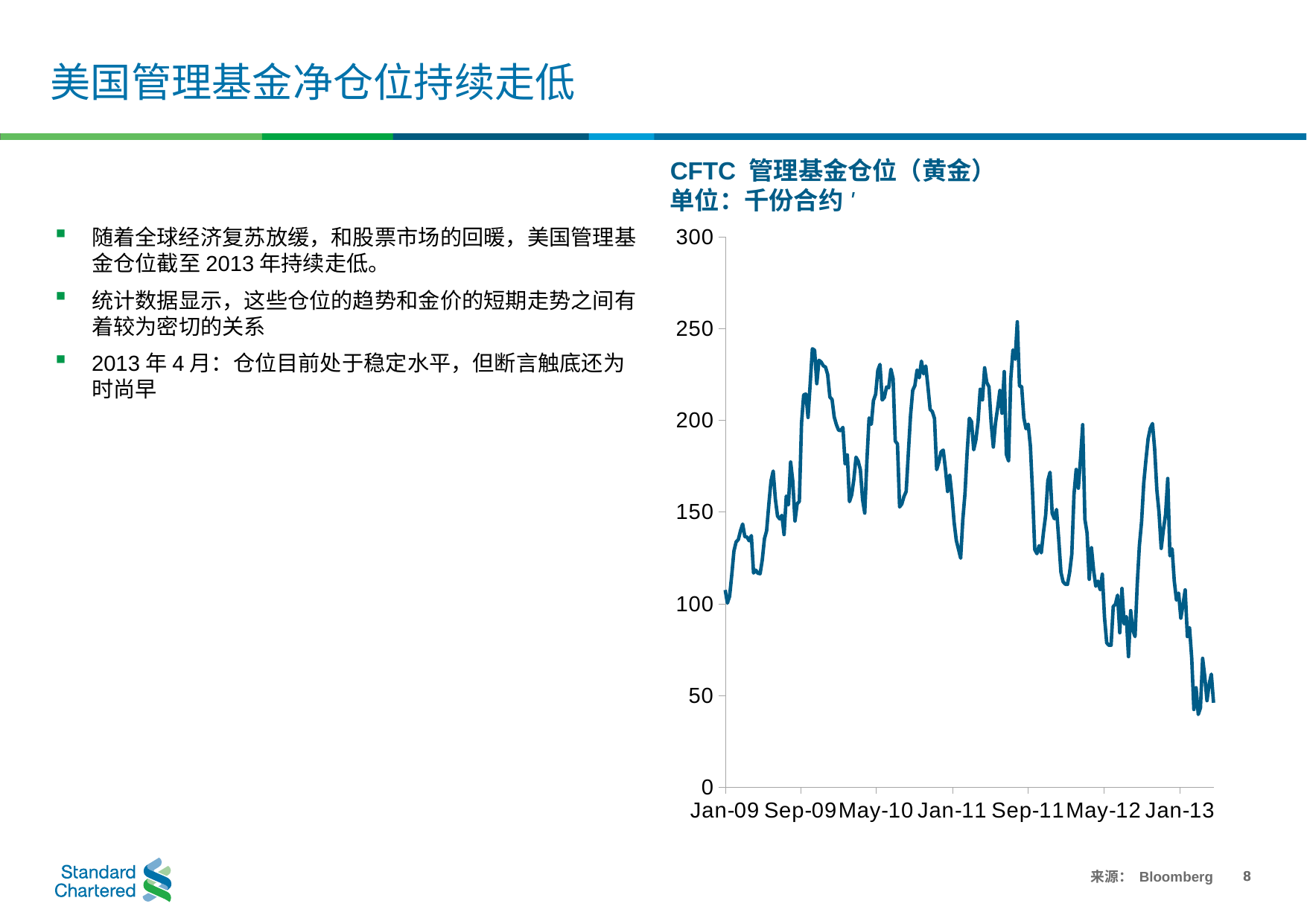
Is the highest point on the line greater or less than 250? greater What kind of chart is shown on the slide? line chart Is the last plotted value (after Jan-13) greater or less than 100? less Is the value at May-12 greater or less than 150? less How many series are plotted on the chart? 1 How many date labels are shown on the x axis? 7 Which is larger, the value at May-10 or the value at May-12? May-10 What unit does the chart state its values are in? 千份合约 Does the line generally rise or fall between Sep-11 and the end of the series? fall What is the title of the chart? CFTC 管理基金仓位（黄金）